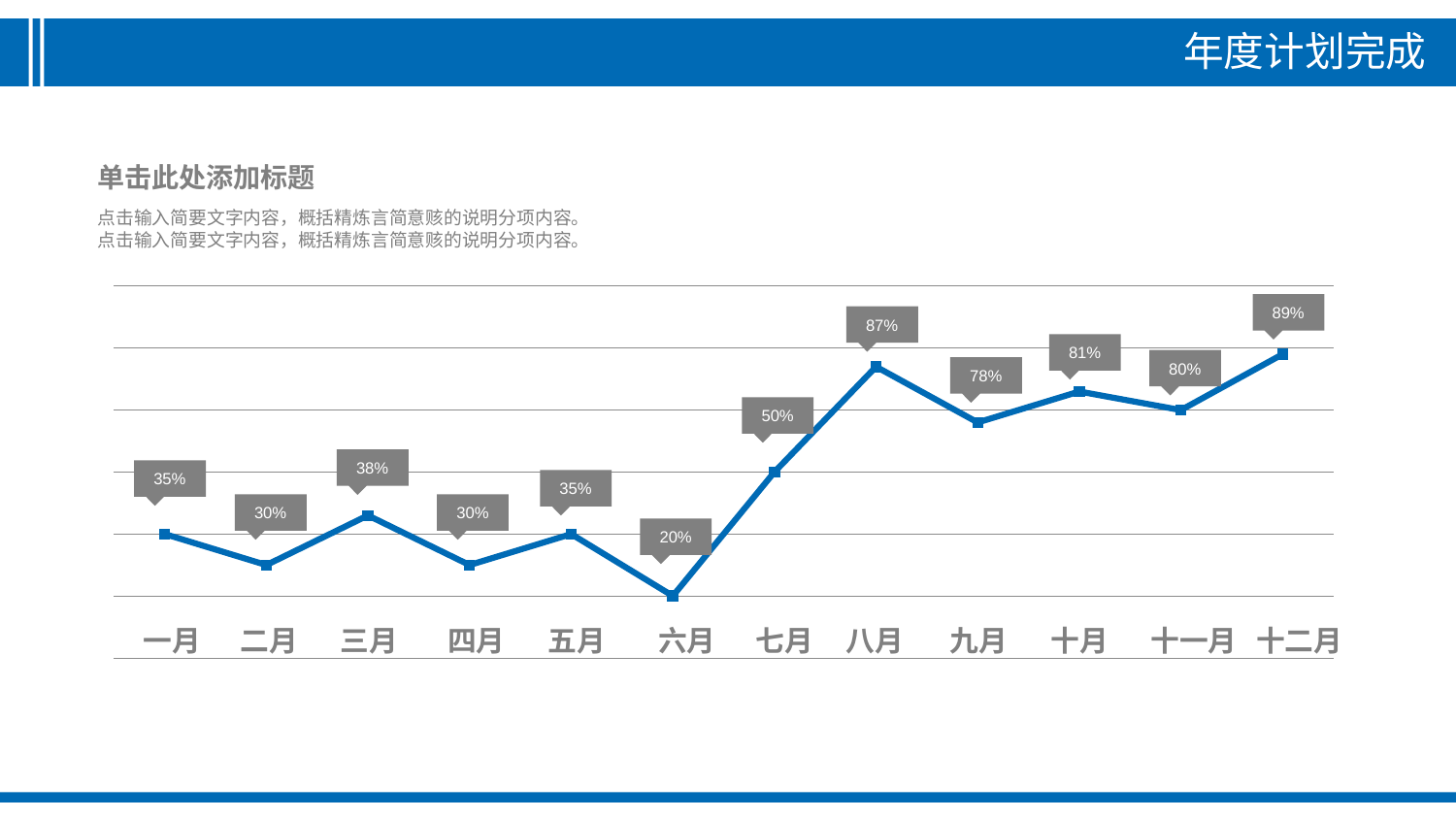
Do the values generally rise or fall from 六月 to 八月? rise What is the value for 三月? 38% What is the difference between the values for 十二月 and 一月? 54% What is the value for 八月? 87% How many months are plotted on the chart? 12 Which month has the lowest value? 六月 What is the value for 六月? 20% What is the value for 十一月? 80% What is the difference between the values for 八月 and 七月? 37% Which month has the highest value? 十二月 Which is larger, the value for 九月 or the value for 十月? 十月 What kind of chart is shown on the slide? line chart